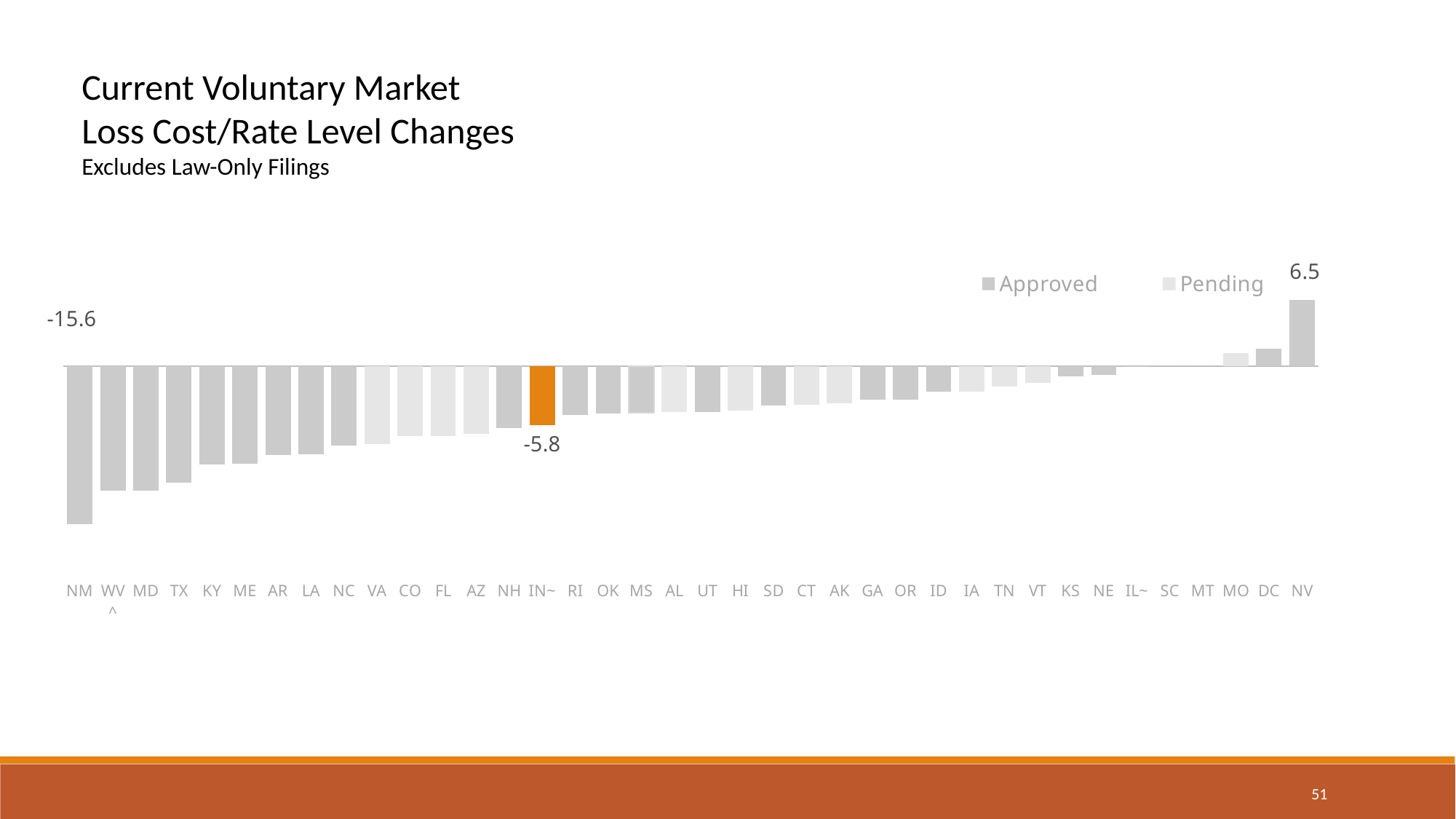
What is the difference between the values for NV and NM? 22.1 Which state has the lowest value? NM How many series does the legend list? 2 How many states are shown on the x axis? 38 What is the value for NM? -15.6 Do the values rise or fall from left to right along the x axis? Rise What kind of chart is shown on the slide? Bar chart What is the value for IN~? -5.8 Which state has the highest value? NV What is the difference between the values for IN~ and NM? 9.8 Which is larger, the value for IN~ or the value for NM? IN~ What is the value for NV? 6.5